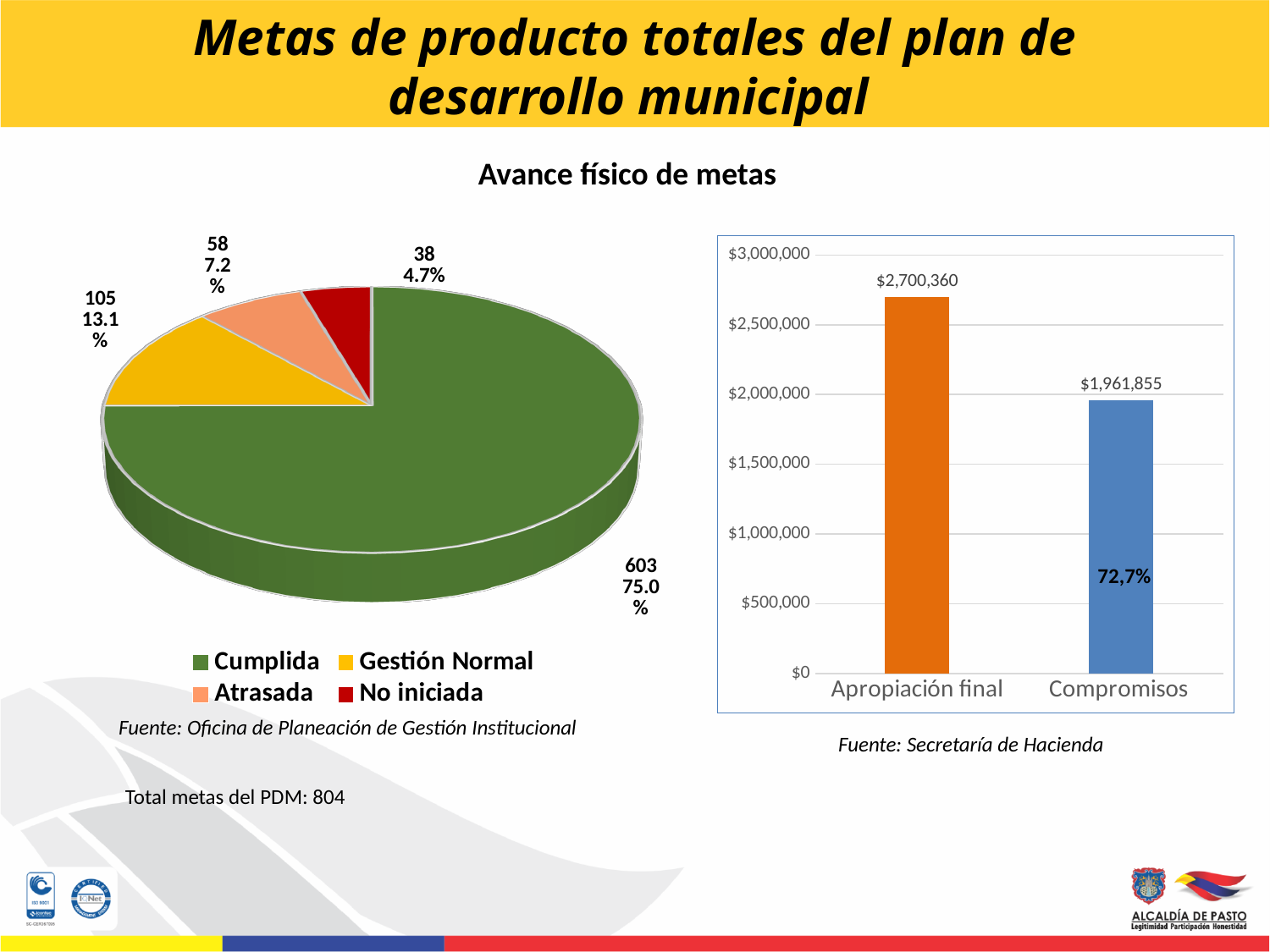
In the bar chart on the right, what is the value for Apropiación final? $2,700,360 In the pie chart 'Avance físico de metas', how many metas are labelled Cumplida? 603 In the bar chart on the right, what is the difference between Apropiación final and Compromisos? $738,505 In the pie chart 'Avance físico de metas', what percentage share does the Atrasada slice have? 7.2% In the pie chart 'Avance físico de metas', what percentage share does the Cumplida slice have? 75.0% What kind of chart is shown on the right side of the slide? Bar chart In the pie chart 'Avance físico de metas', what is the difference between the Cumplida count and the No iniciada count? 565 In the pie chart 'Avance físico de metas', what colour is the Gestión Normal slice? Yellow In the pie chart 'Avance físico de metas', how many categories does the legend list? 4 In the pie chart 'Avance físico de metas', what is the value for Gestión Normal? 105 In the bar chart on the right, what is the value for Compromisos? $1,961,855 In the pie chart 'Avance físico de metas', which category has the smallest slice? No iniciada